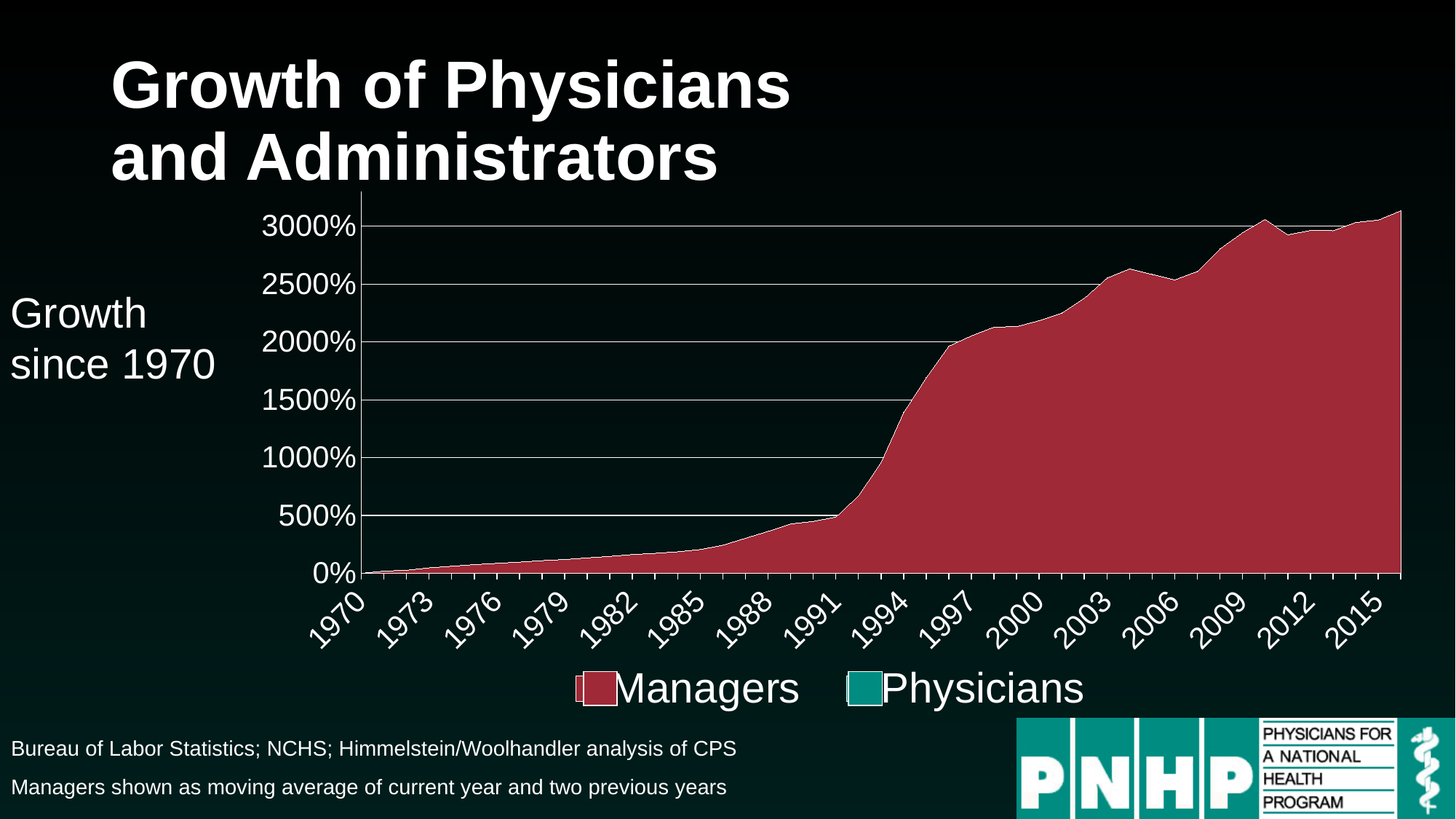
Is the Managers value for 1988 greater or less than 500%? less What kind of chart is shown on the slide? Area chart What are the two series named in the legend? Managers and Physicians What colour is the Managers series in the chart? Red Is the Managers value for 1994 greater or less than 1000%? greater What is the Managers growth value at 1970? 0% Is the Managers value for 1997 greater or less than 1500%? greater Do the Managers values generally rise or fall from 1970 to 2015? Rise How many year labels are shown on the x axis? 16 How many series does the legend list? 2